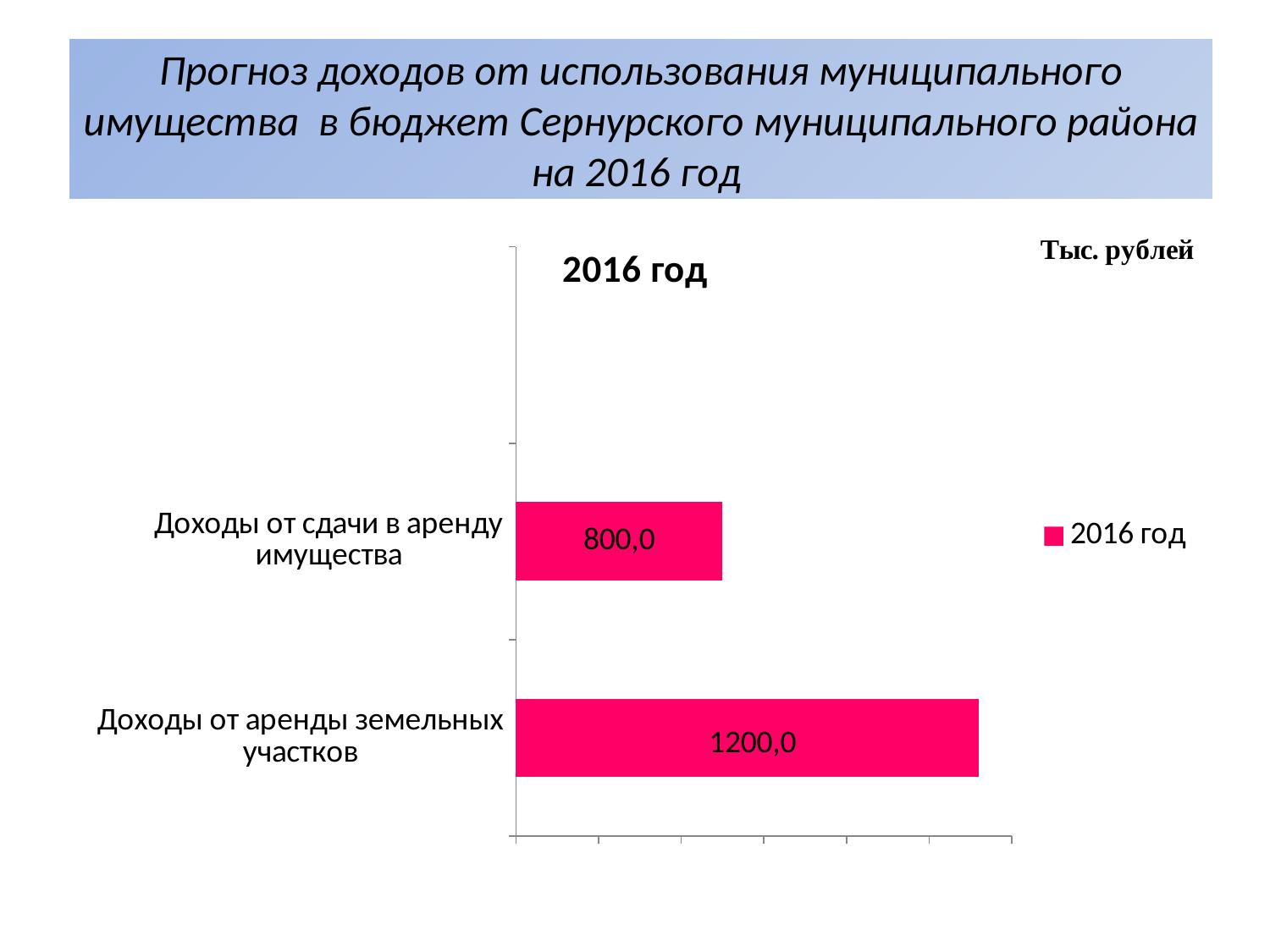
What series name is listed in the legend? 2016 год What is the title of the chart? 2016 год What kind of chart is shown on the slide? bar chart What is the difference between the value for Доходы от аренды земельных участков and the value for Доходы от сдачи в аренду имущества? 400,0 How many series does the legend list? 1 What is the value for Доходы от сдачи в аренду имущества? 800,0 Which category has the lowest value? Доходы от сдачи в аренду имущества Which is larger: the value for Доходы от сдачи в аренду имущества or the value for Доходы от аренды земельных участков? Доходы от аренды земельных участков How many categories are shown in the chart? 2 What is the value for Доходы от аренды земельных участков? 1200,0 Which category has the highest value? Доходы от аренды земельных участков